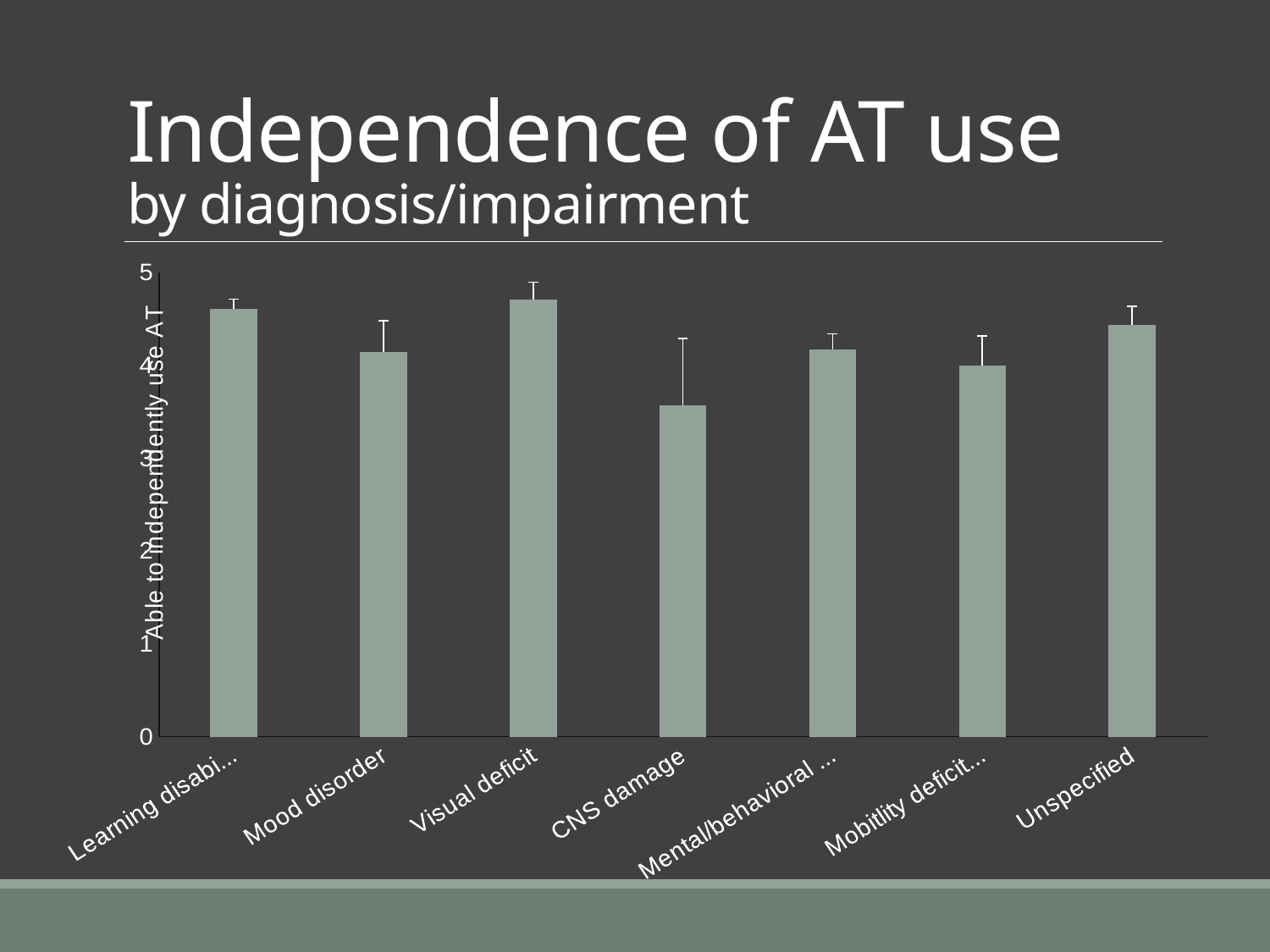
Is the value for CNS damage greater or less than 3? greater Is the value for CNS damage greater or less than 4? less Which category has the lowest bar in the chart? CNS damage Which is larger, the value for Visual deficit or the value for CNS damage? Visual deficit Is the value for Unspecified greater or less than 4? greater How many diagnosis/impairment categories are plotted in the chart? 7 What is the title of the slide containing the chart? Independence of AT use by diagnosis/impairment What kind of chart is shown on the slide? bar chart Which is larger, the value for Visual deficit or the value for Mood disorder? Visual deficit Which is larger, the value for Unspecified or the value for CNS damage? Unspecified What is the label on the vertical axis of the chart? Able to independently use AT